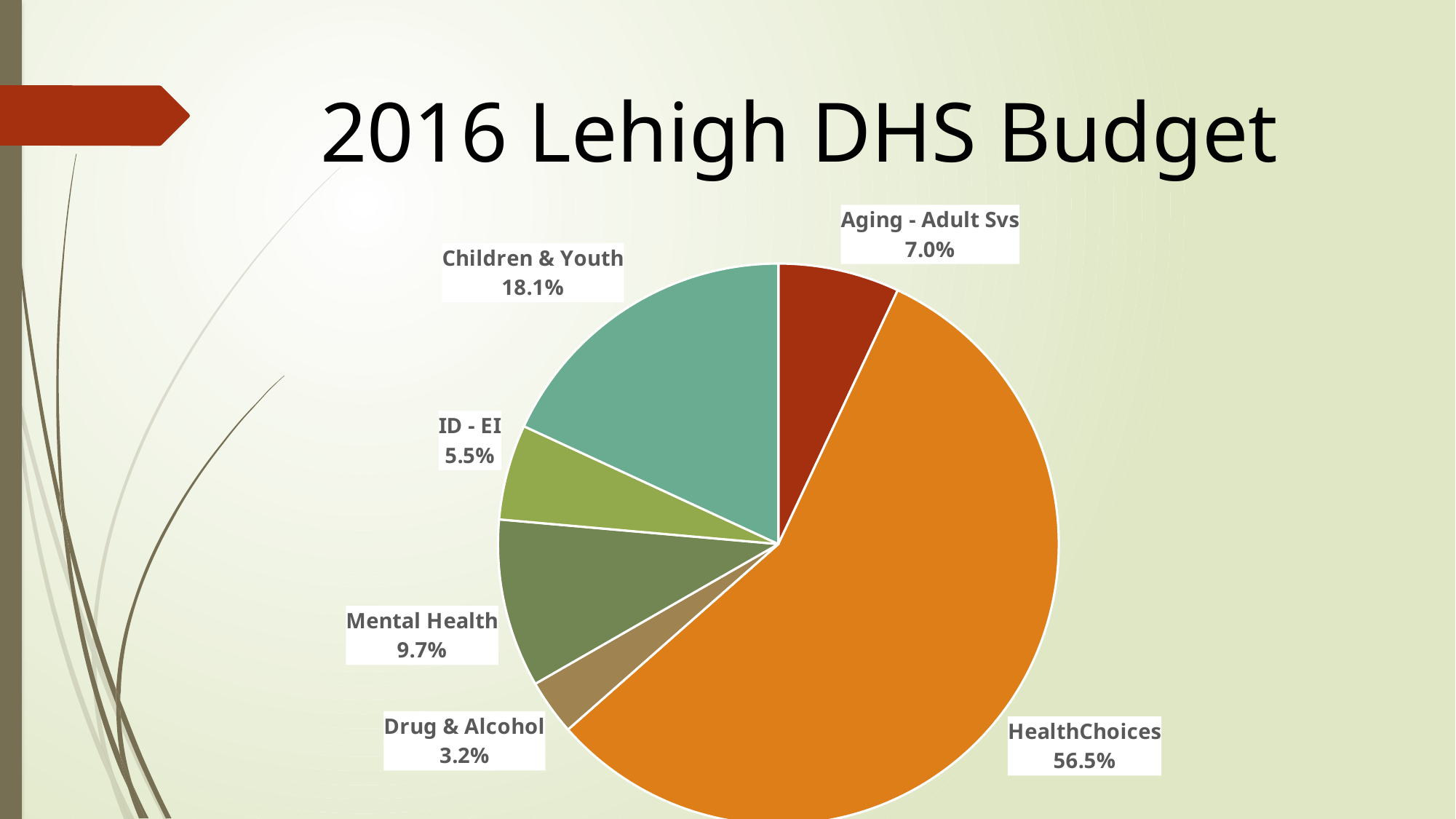
What is the value shown for Mental Health? 9.7% How many categories are shown in the pie chart? 6 What is the difference between the Children & Youth share and the Mental Health share? 8.4% What colour is the HealthChoices slice? orange What share of the 2016 Lehigh DHS Budget goes to HealthChoices? 56.5% What percentage is shown for Aging - Adult Svs? 7.0% What percentage of the budget is allocated to Children & Youth? 18.1% What kind of chart is shown on the slide? pie chart Which is larger, the share for ID - EI or the share for Aging - Adult Svs? Aging - Adult Svs Which category has the smallest share of the budget? Drug & Alcohol What is the title of the chart? 2016 Lehigh DHS Budget Which category has the largest share of the budget? HealthChoices